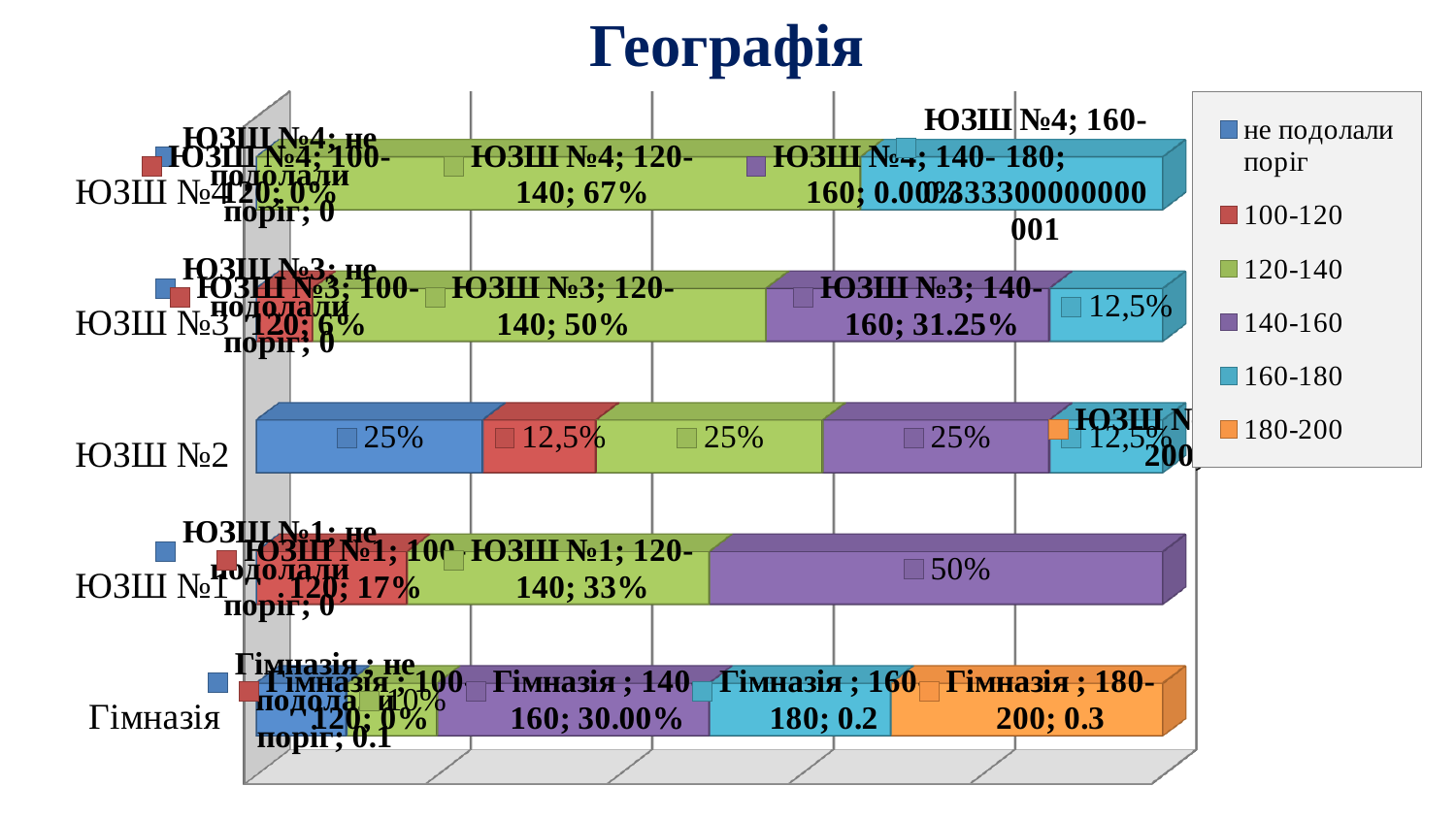
What is the value of the 140-160 segment for ЮЗШ №1? 50% What is the value of the 100-120 segment for ЮЗШ №2? 12,5% How many series does the legend list? 6 For ЮЗШ №1, what is the difference between the 140-160 segment and the 100-120 segment? 33% What is the title of the chart? Географія What is the value of the 120-140 segment for ЮЗШ №4? 67% For ЮЗШ №3, which is larger: the 120-140 segment or the 140-160 segment? 120-140 What is the value of the 180-200 segment for Гімназія? 0.3 How many schools (categories) are shown on the chart? 5 What is the value of the 140-160 segment for ЮЗШ №3? 31.25% What kind of chart is shown on the slide? Stacked bar chart Which score range has the largest share for ЮЗШ №4? 120-140